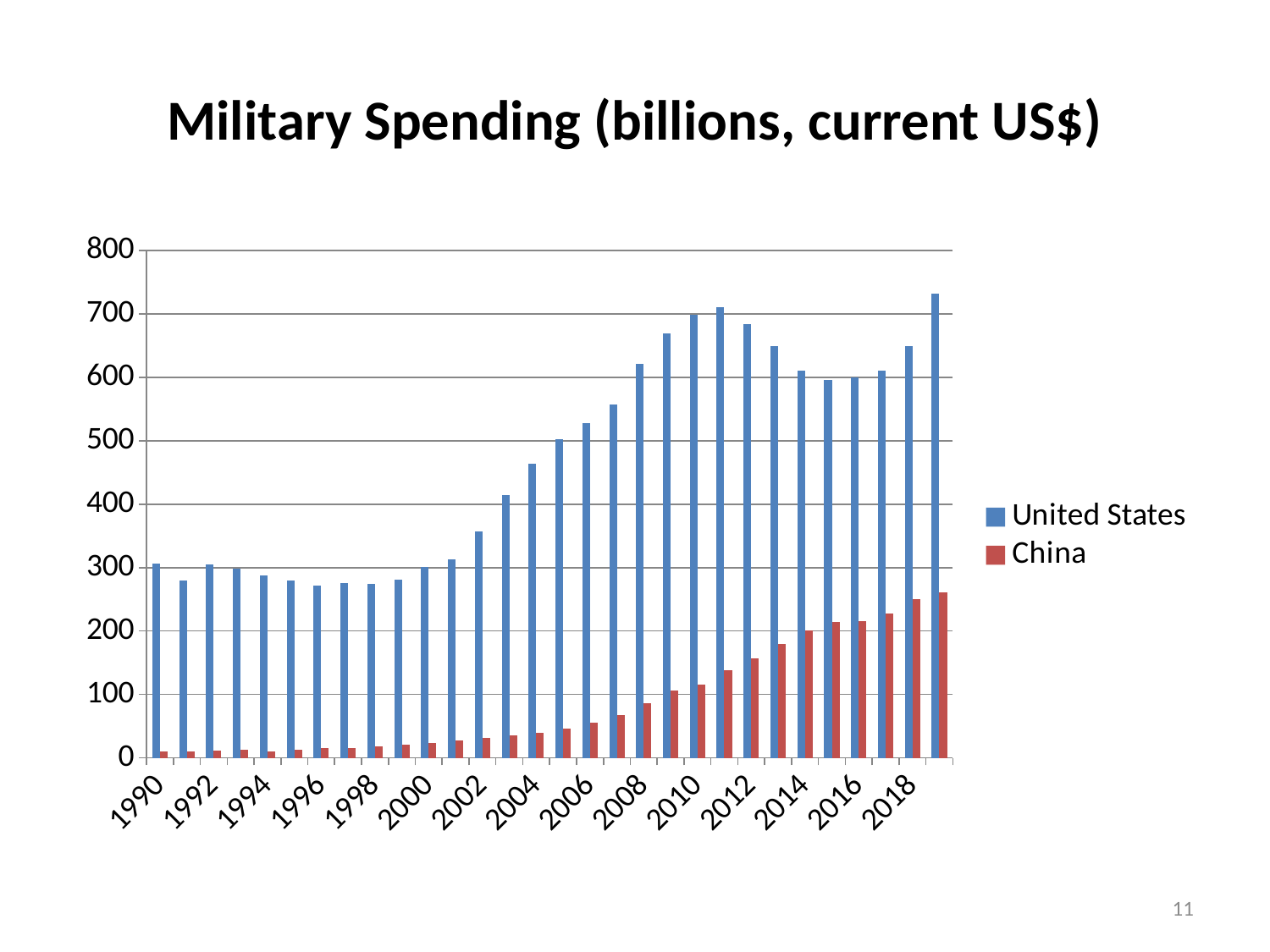
Which is larger: United States spending in 2010 or in 2015? 2010 What is the title of the chart? Military Spending (billions, current US$) Is the value for China in 2000 greater or less than 100? less Is the value for the United States in 1990 greater or less than 400? less Does China's military spending rise or fall from 1990 to 2019? rise Is the value for the United States in 2010 greater or less than 600? greater In which year is China's military spending highest? 2019 How many series does the legend list? 2 What kind of chart is shown on the slide? bar chart Which series is shown in red? China In which year is United States military spending highest? 2019